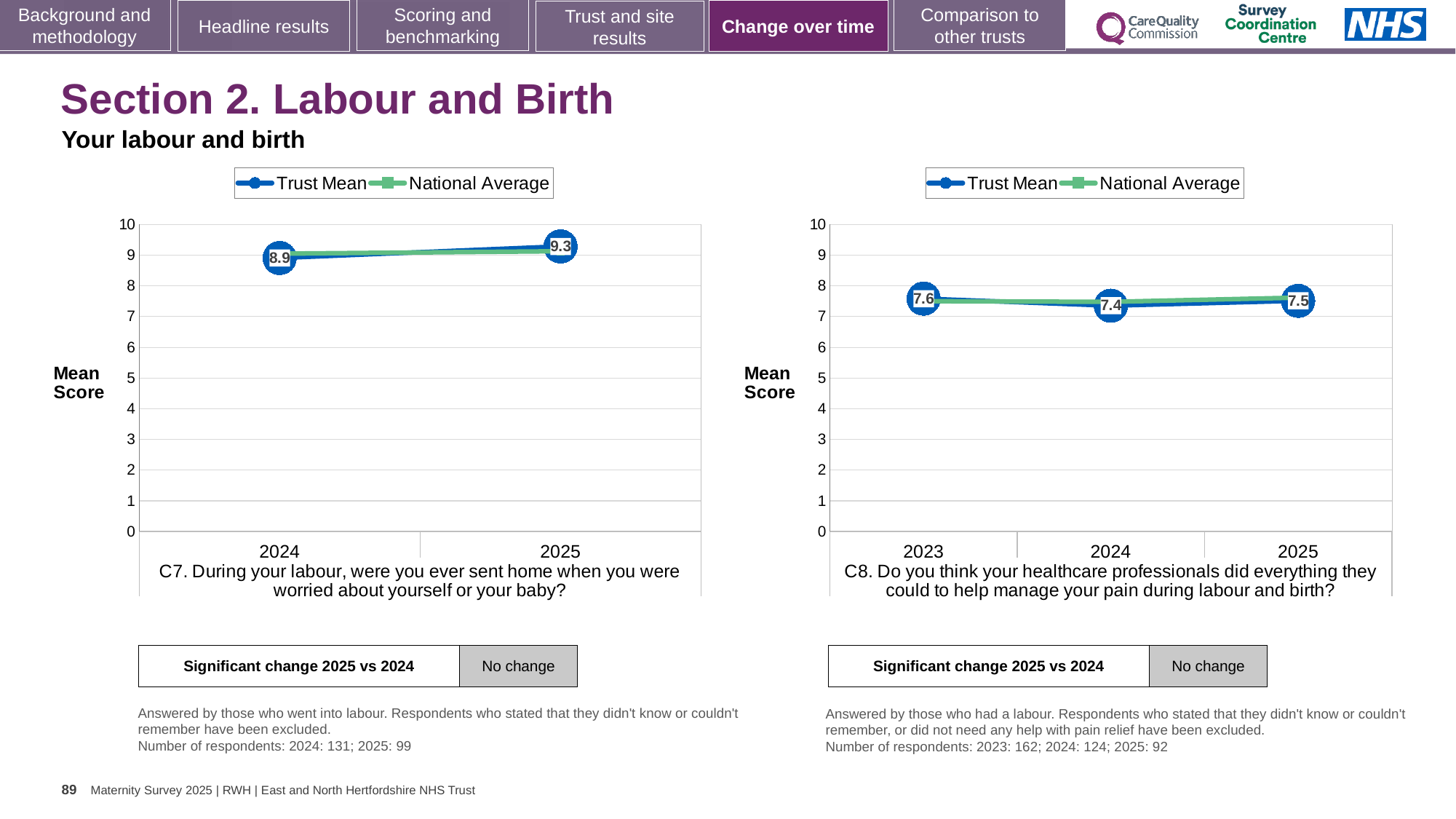
On the right chart (C8), which year has the lowest Trust Mean? 2024 How many series does the legend of the left chart (C7) list? 2 On the right chart (C8), what is the Trust Mean for 2023? 7.6 On the left chart (C7), does the Trust Mean rise or fall from 2024 to 2025? Rise On the right chart (C8), what is the Trust Mean for 2024? 7.4 On the left chart (C7), what is the Trust Mean for 2024? 8.9 What type of chart is the left chart (C7)? Line chart On the left chart (C7), what is the difference between the Trust Mean for 2025 and 2024? 0.4 On the left chart (C7), what is the Trust Mean for 2025? 9.3 How many years are plotted on the right chart (C8)? 3 On the right chart (C8), which year has the highest Trust Mean? 2023 On the right chart (C8), is the Trust Mean for 2025 greater or less than 8? less